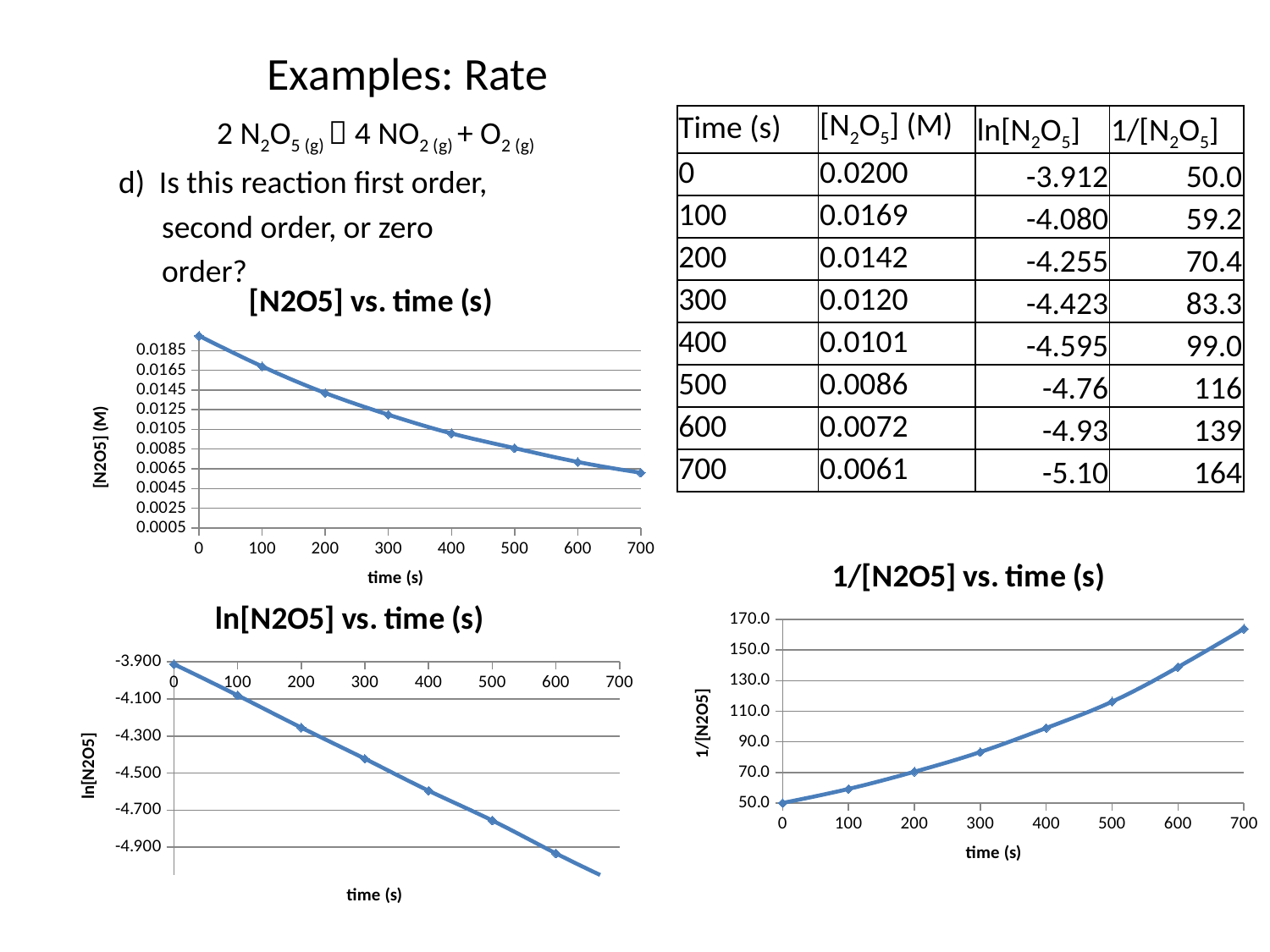
What kind of chart is the "[N2O5] vs. time (s)" chart? line chart In the "[N2O5] vs. time (s)" chart, at which time is the value lowest? 700 In the "[N2O5] vs. time (s)" chart, do the values rise or fall as time increases? fall How many data points are plotted in the "1/[N2O5] vs. time (s)" chart? 8 In the "1/[N2O5] vs. time (s)" chart, is the value at 600 s greater or less than 130.0? greater In the "1/[N2O5] vs. time (s)" chart, do the values rise or fall as time increases? rise In the "ln[N2O5] vs. time (s)" chart, do the values rise or fall as time increases? fall In the "ln[N2O5] vs. time (s)" chart, is the value at 500 s greater or less than -4.700? less In the "[N2O5] vs. time (s)" chart, is the value at 400 s greater or less than 0.0125? less In the "1/[N2O5] vs. time (s)" chart, at which time is the value highest? 700 What is the x-axis label of the "ln[N2O5] vs. time (s)" chart? time (s)